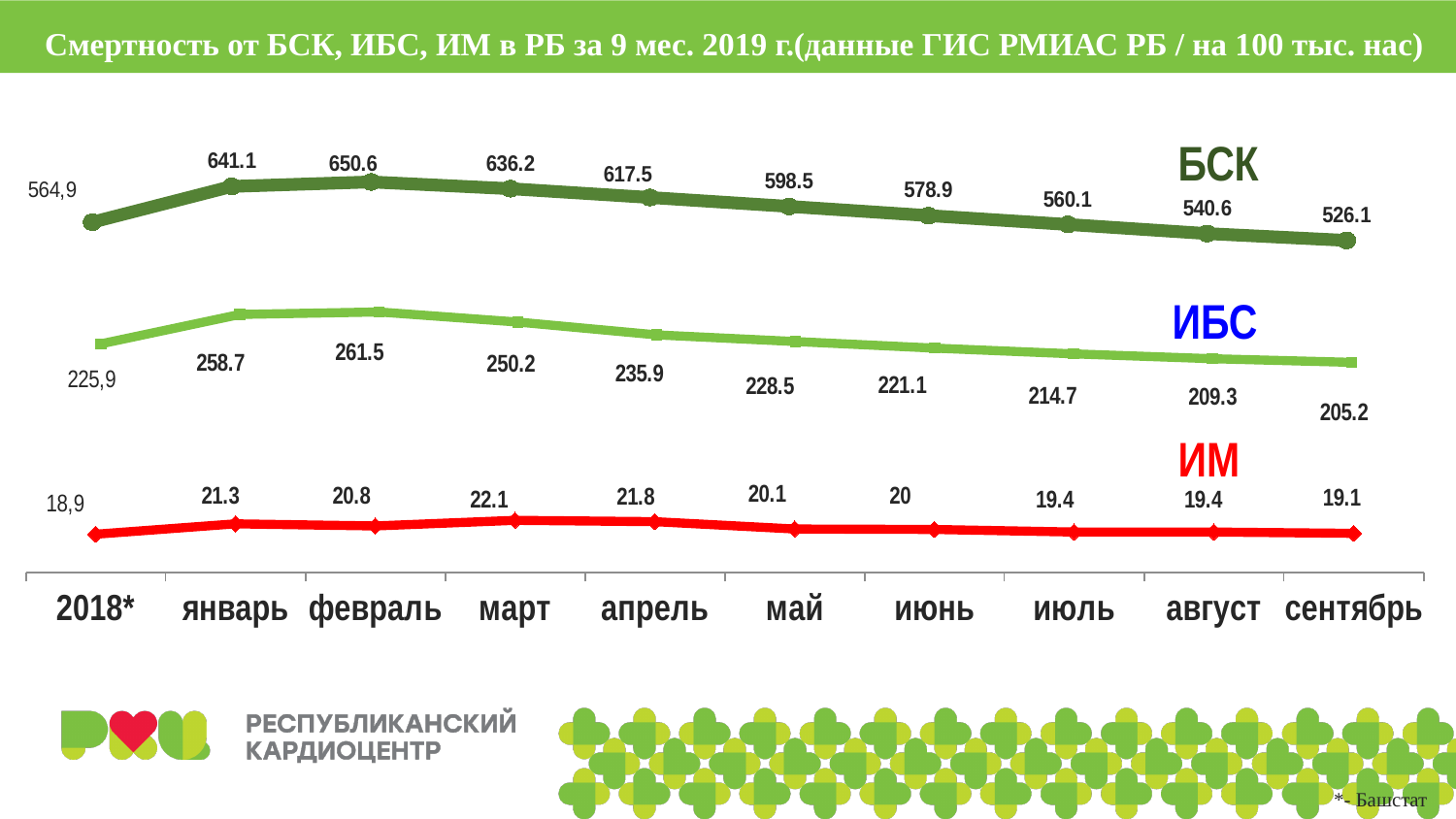
What is the ИБС value for сентябрь? 205.2 What is the БСК value for февраль? 650.6 In which month is the ИБС value lowest? сентябрь In which month is the БСК value highest? февраль How many series does the chart show? 3 How many points along the x axis does each line have? 10 Does the БСК line rise or fall from февраль to сентябрь? fall What is the difference between the БСК values for январь and сентябрь? 115.0 What is the ИМ value for март? 22.1 What is the label of the red line? ИМ Which is larger, the ИМ value for апрель or for май? апрель What kind of chart is shown on the slide? line chart